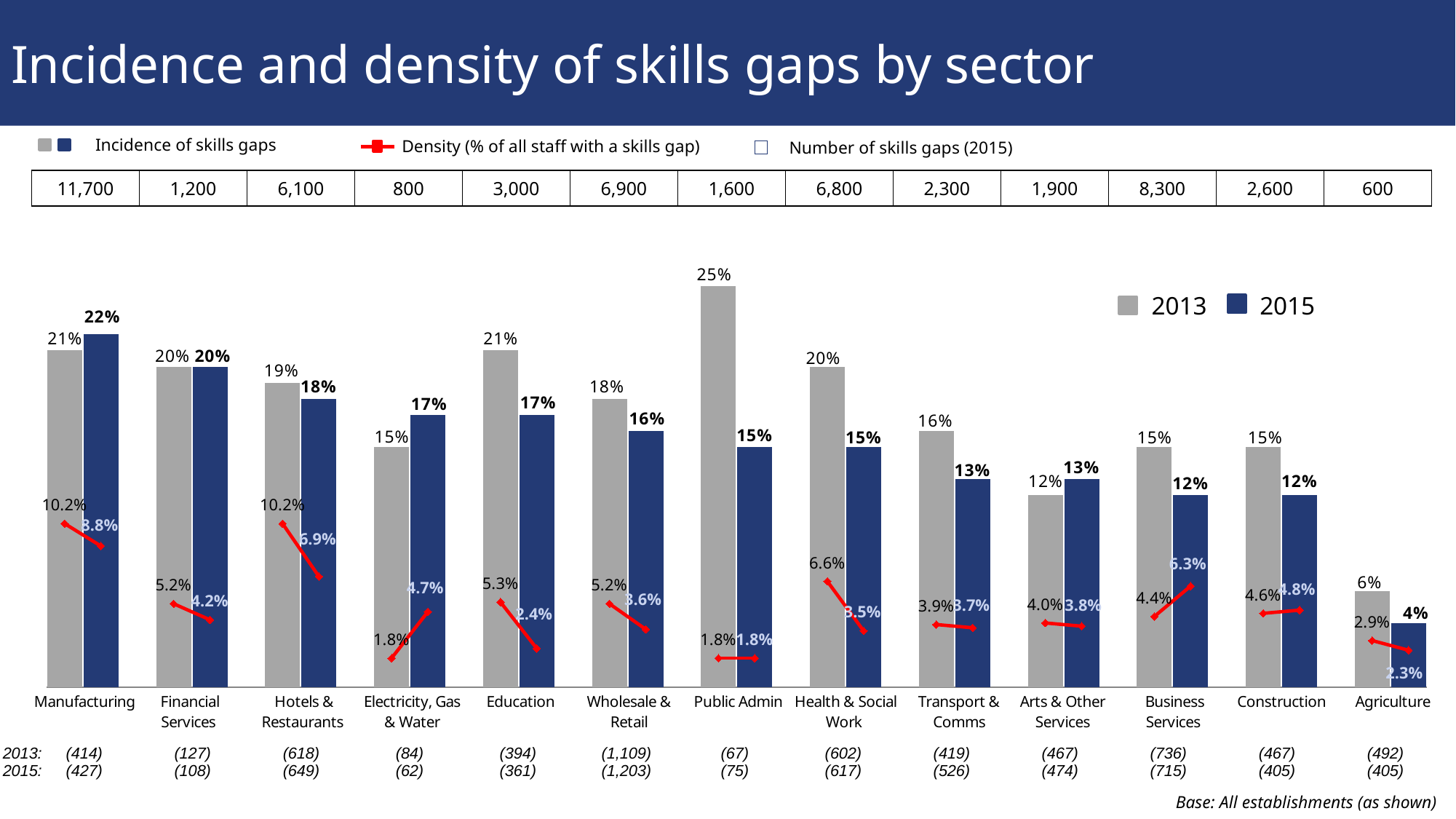
By how many percentage points did the incidence of skills gaps in Public Admin fall between 2013 and 2015? 10 percentage points What was the density of skills gaps in Electricity, Gas & Water in 2015? 4.7% What is the number of skills gaps (2015) shown for Business Services? 8,300 How many sectors are shown on the chart? 13 Which was larger in 2015: the incidence of skills gaps in Education or in Wholesale & Retail? Education Which colour represents 2015 in the bar chart? Dark blue What type of chart is used to show the incidence of skills gaps? Bar chart Which sector had the lowest incidence of skills gaps in 2015? Agriculture Which sector had the highest incidence of skills gaps in 2013? Public Admin What was the incidence of skills gaps in Manufacturing in 2015? 22% How many years does the bar legend list? 2 What was the density of skills gaps in Hotels & Restaurants in 2013? 10.2%